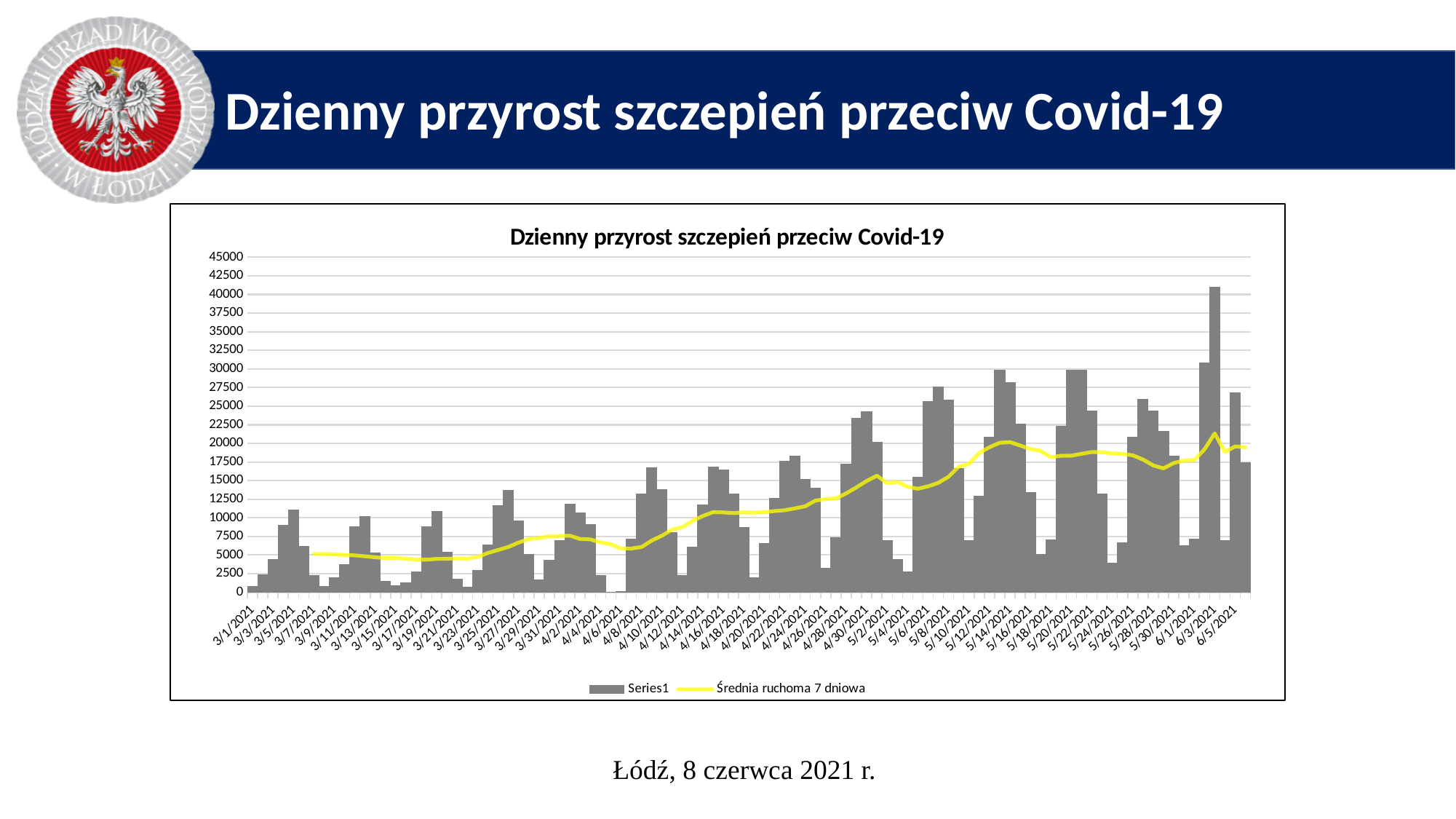
How many series does the chart legend list? 2 What is the title of the chart? Dzienny przyrost szczepień przeciw Covid-19 Which is higher: the 7-day moving average at the start of the chart (early March) or at the end of the chart (early June)? At the end of the chart (early June) Is the 7-day moving average at the start of the chart (3/7/2021) greater or less than 10000? less What is the last date label shown on the chart's horizontal axis? 6/5/2021 Is the tallest bar on the chart greater or less than 40000? greater What are the two legend entries of the chart? Series1 and Średnia ruchoma 7 dniowa Is the value for 3/1/2021 greater or less than 5000? less Does the 7-day moving average line (Średnia ruchoma 7 dniowa) generally rise or fall from March to June 2021? rise What kind of chart is shown on the slide? A bar chart with a line overlay (combination chart) What is the highest value shown on the chart's vertical axis? 45000 What is the first date shown on the chart's horizontal axis? 3/1/2021